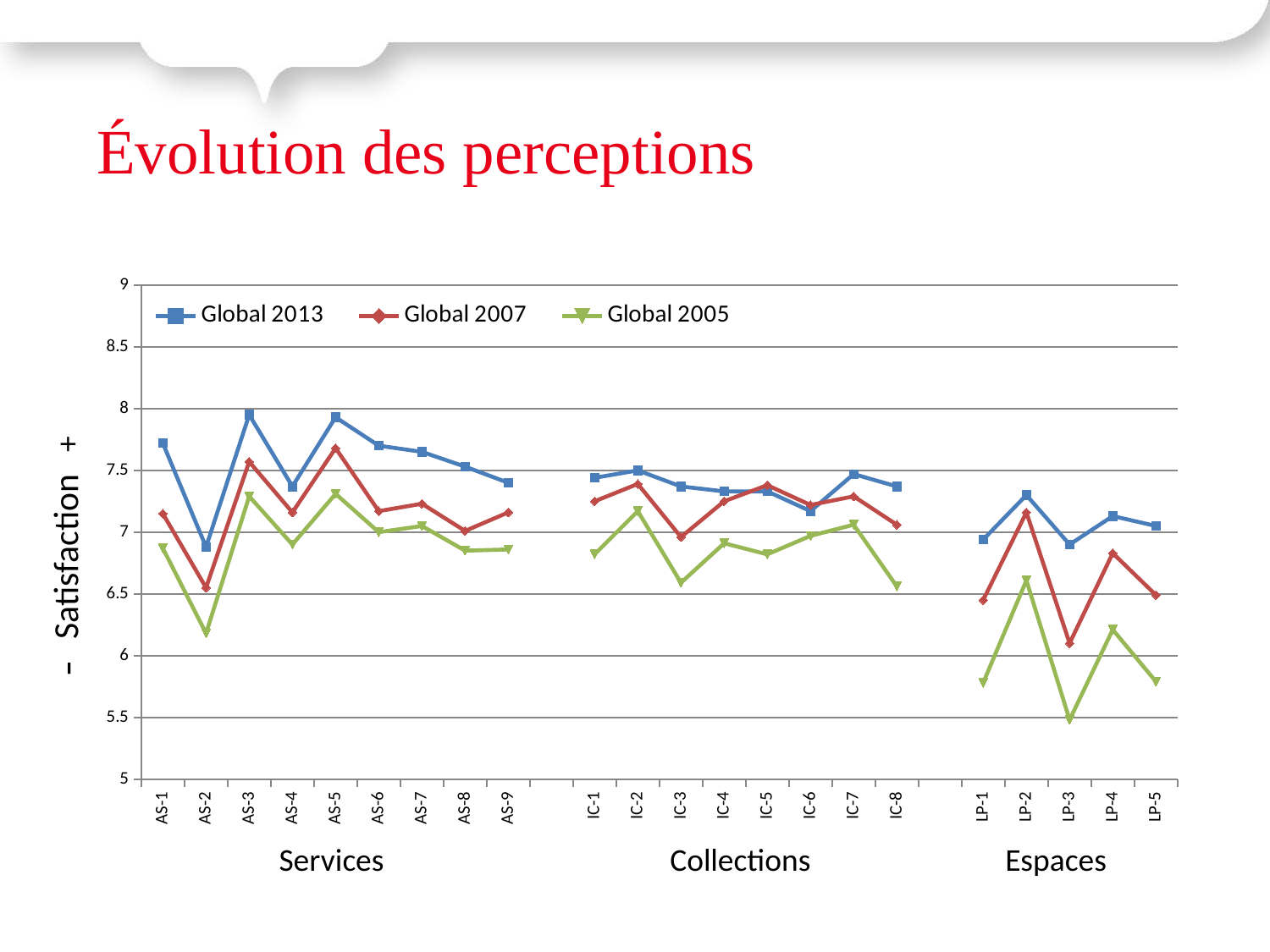
At AS-2, which series has the larger value, Global 2013 or Global 2005? Global 2013 For Global 2005, which is larger, the value at LP-2 or the value at LP-3? LP-2 Does the Global 2013 line rise or fall from AS-5 to AS-9? fall Is the value of Global 2013 at IC-2 greater or less than 7? greater Is the value of Global 2007 at LP-3 greater or less than 6.5? less How many categories are plotted along the x axis? 22 Is the value of Global 2005 at LP-3 greater or less than 6? less What kind of chart is shown on the slide? line chart What are the three group labels shown below the x axis? Services, Collections, Espaces How many series does the legend list? 3 Which category has the lowest value for Global 2005? LP-3